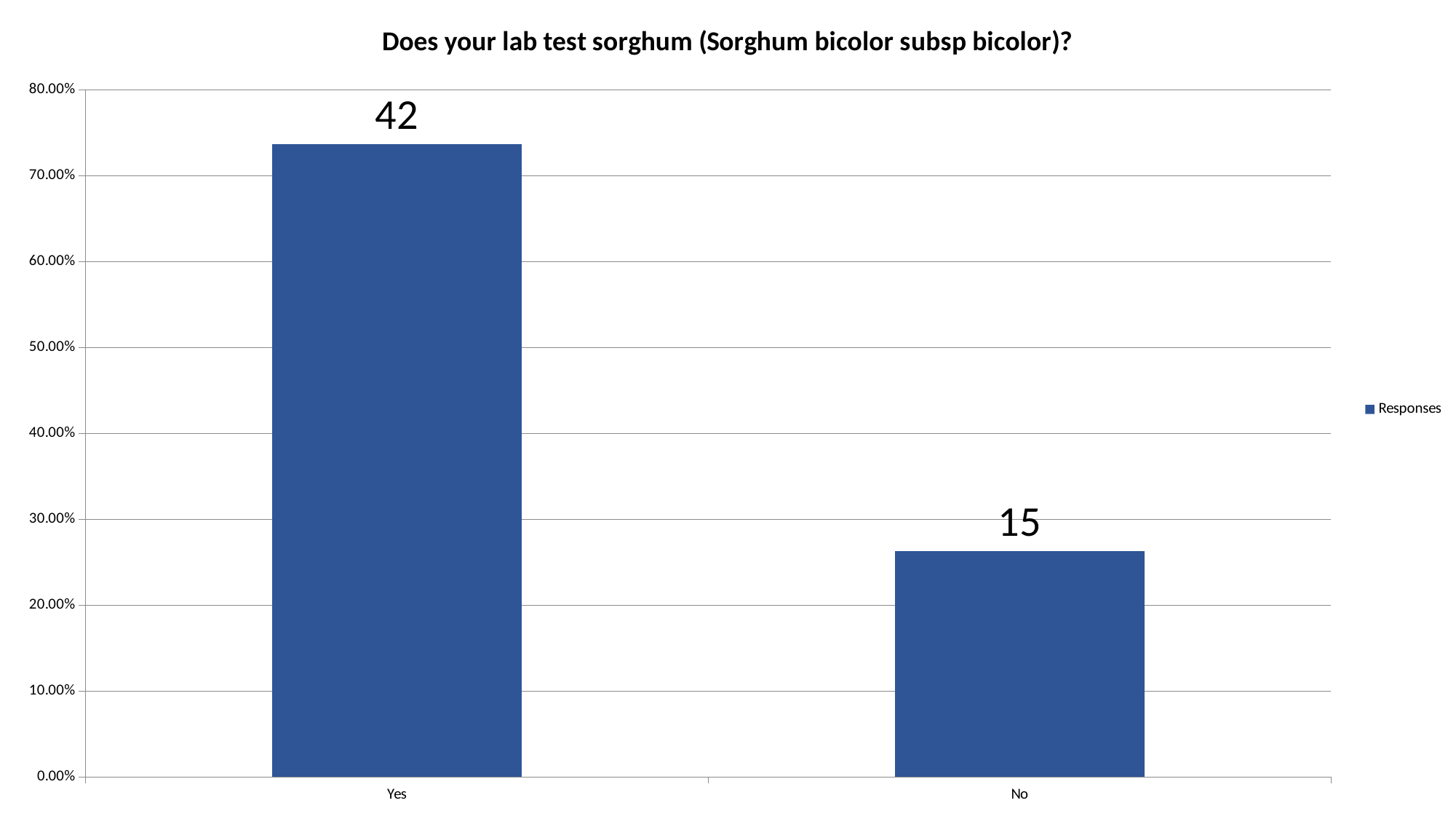
Which bar is taller, Yes or No? Yes Which category has the lowest bar? No What is the data label shown on the bar for Yes? 42 What is the title of the chart? Does your lab test sorghum (Sorghum bicolor subsp bicolor)? What is the data label shown on the bar for No? 15 How many categories are shown on the x axis? 2 How many series does the legend list? 1 Which category has the highest bar? Yes What kind of chart is shown on the slide? bar chart What is the difference between the data labels for Yes and No? 27 Is the value for Yes greater or less than 70.00%? greater Is the value for No greater or less than 30.00%? less